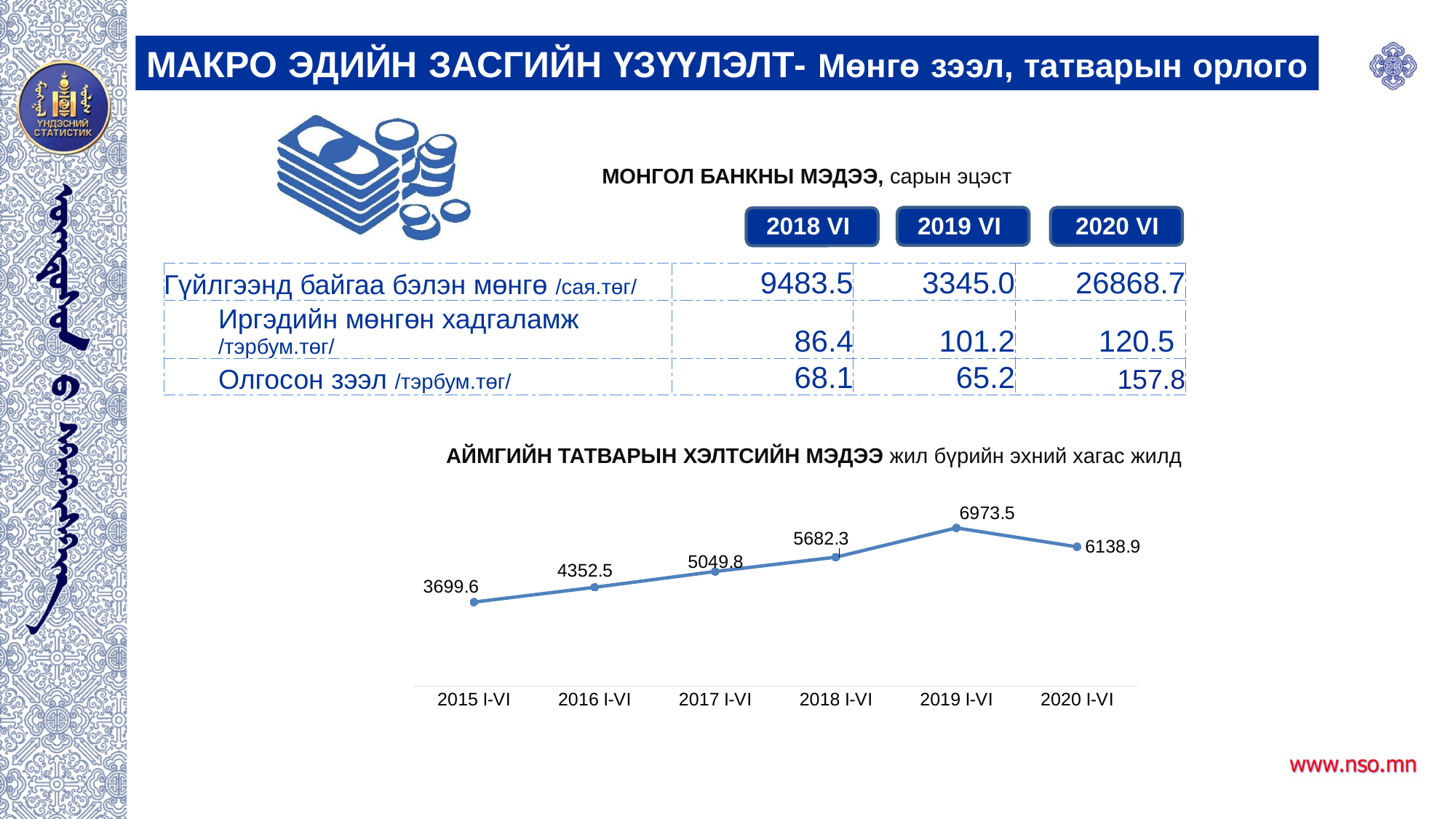
Which period has the highest value in the line chart? 2019 I-VI Which is larger in the line chart, the value for 2017 I-VI or the value for 2018 I-VI? 2018 I-VI What is the difference between the values for 2016 I-VI and 2015 I-VI in the line chart? 652.9 What is the title of the line chart? АЙМГИЙН ТАТВАРЫН ХЭЛТСИЙН МЭДЭЭ жил бүрийн эхний хагас жилд What kind of chart is shown on the slide? line chart What is the value for 2015 I-VI in the line chart? 3699.6 Do the values in the line chart rise or fall from 2015 I-VI to 2019 I-VI? rise Which period has the lowest value in the line chart? 2015 I-VI How many data points are plotted in the line chart? 6 What is the difference between the values for 2019 I-VI and 2020 I-VI in the line chart? 834.6 What is the value for 2018 I-VI in the line chart? 5682.3 What is the value for 2020 I-VI in the line chart? 6138.9